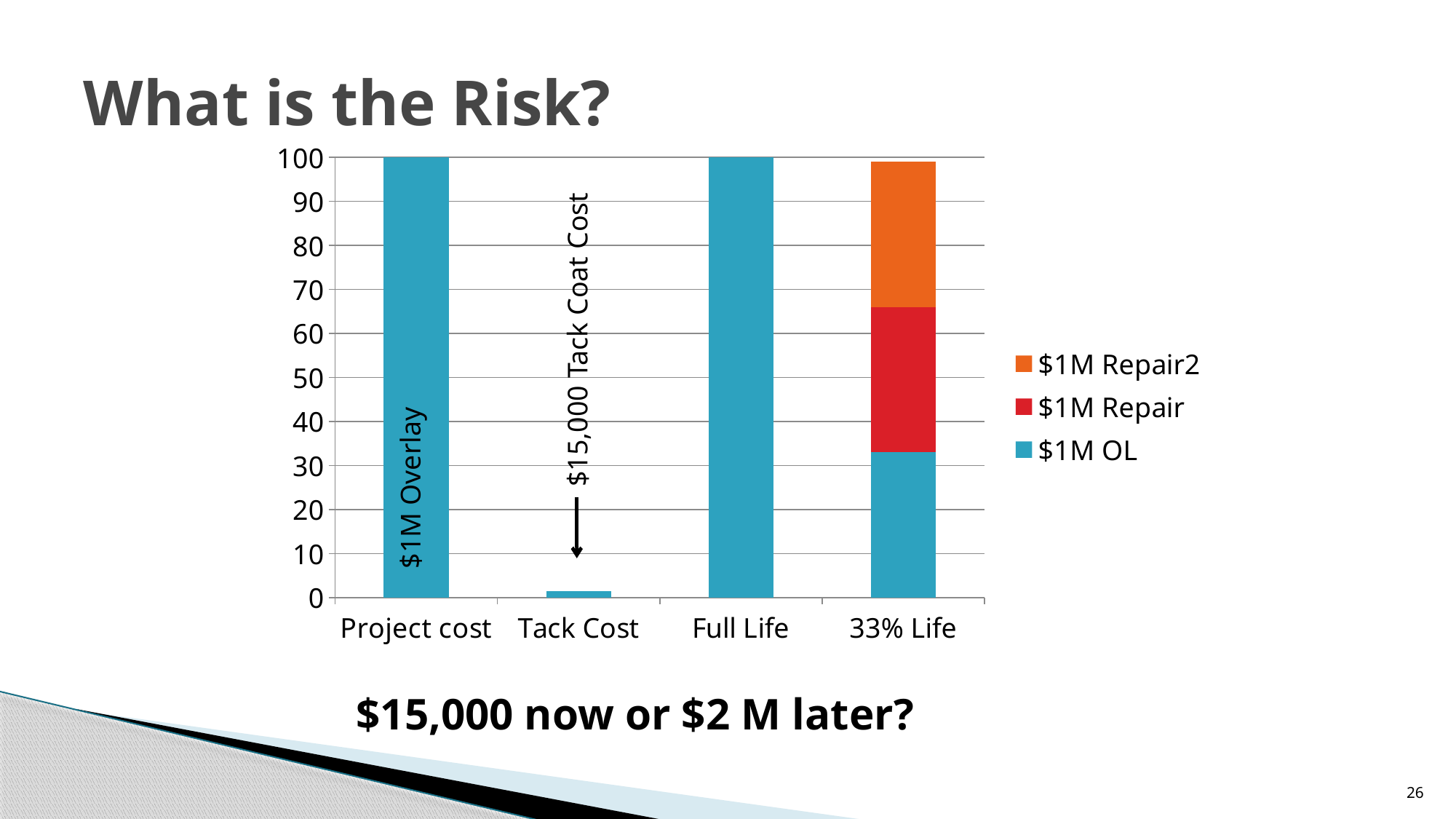
What text label is written next to the arrow pointing at the Tack Cost bar? $15,000 Tack Coat Cost Which is larger, the Project cost bar or the Tack Cost bar? Project cost What is the value of the Project cost bar? 100 Which category's bar is made up of three stacked segments? 33% Life Is the $1M OL value for 33% Life greater or less than 50? less Is the $1M OL value for 33% Life greater or less than 20? greater What kind of chart is shown on the slide? Stacked bar chart Which category has the lowest bar? Tack Cost How many categories are shown on the x axis of the chart? 4 How many series does the chart's legend list? 3 What is the value of the Full Life bar? 100 Is the value for Tack Cost greater or less than 10? less